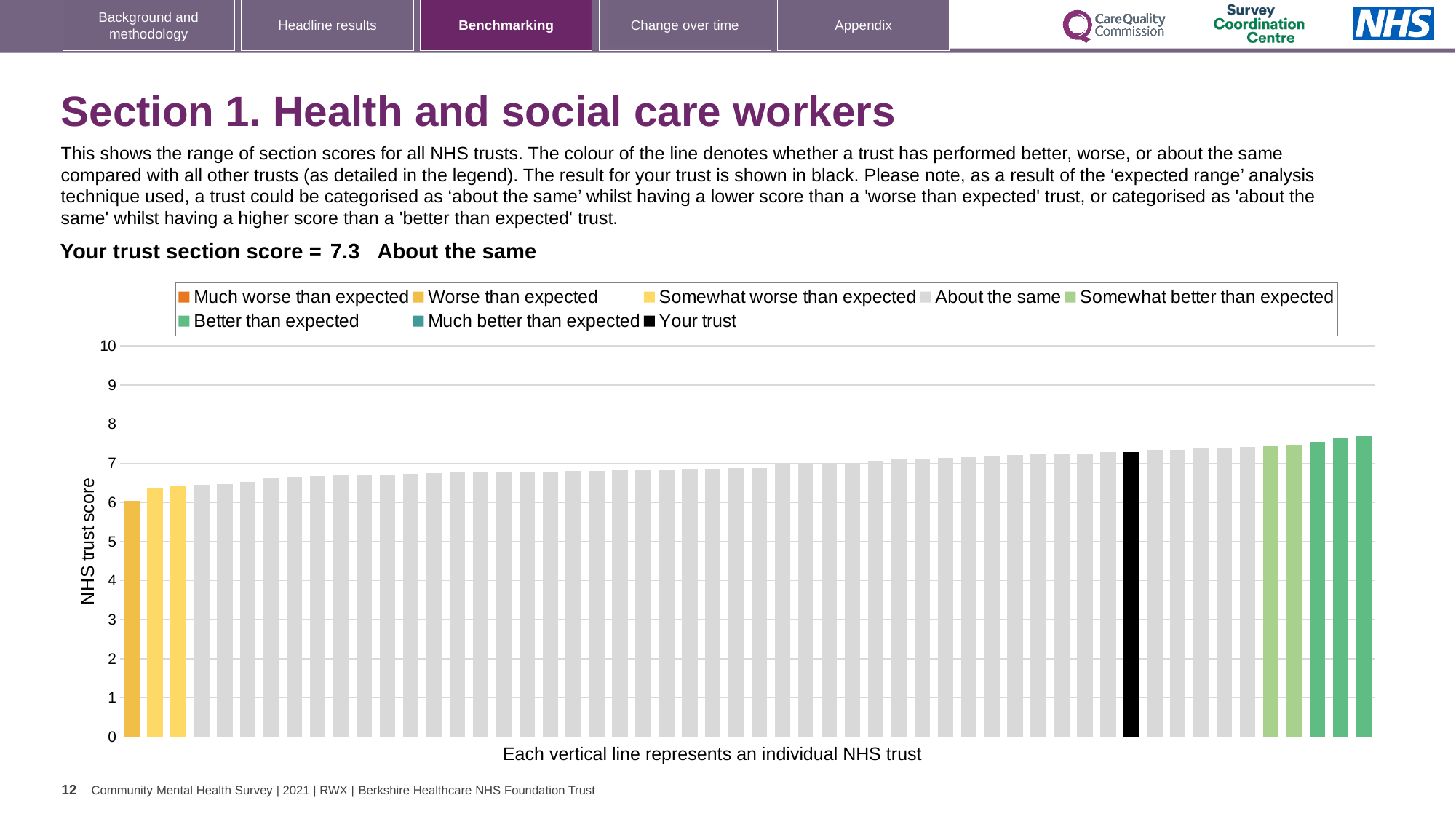
Is the value for the highest-scoring trust (the rightmost bar) greater or less than 8? less Which is larger, the value for the rightmost bar or the value for your trust (black bar)? the rightmost bar Which is larger, the value for your trust (black bar) or the value for the leftmost bar? your trust (black bar) Is the value for your trust (the black bar) greater or less than 7? greater What is the label on the y axis of the chart? NHS trust score What is the highest value shown on the y axis of the chart? 10 How many entries does the chart legend list? 8 Is the value for the lowest-scoring trust (the leftmost bar) greater or less than 5? greater What category does the black bar in the chart represent, according to the legend? Your trust What is the section score for your trust shown on the chart? 7.3 What kind of chart is shown on the slide? bar chart Do the bar values rise or fall moving from left to right along the x axis? rise